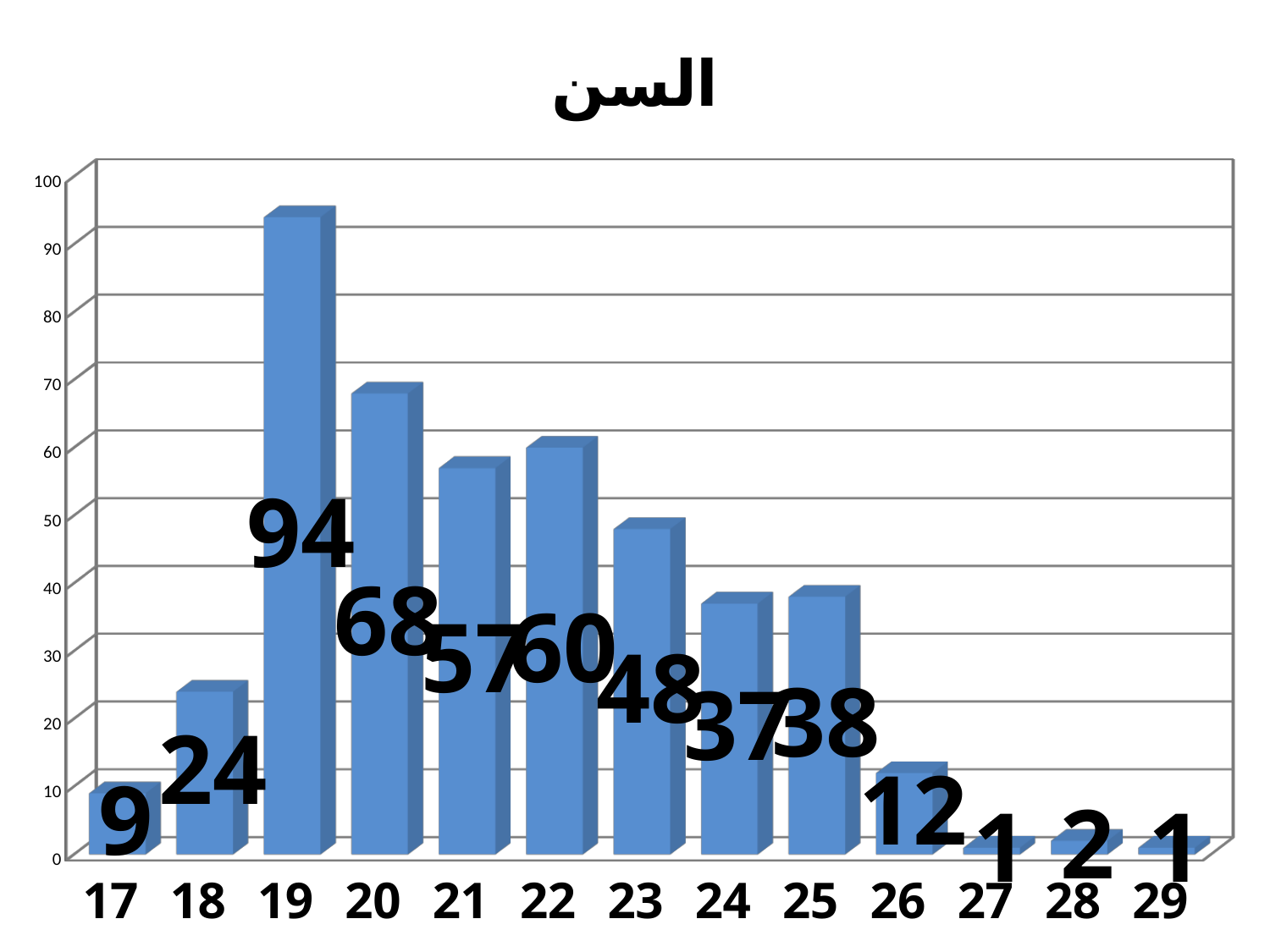
What is the value for age 19? 94 Which is larger, the value for age 21 or the value for age 22? 22 Is the value for age 19 greater or less than 90? greater What is the value for age 23? 48 What is the value for age 26? 12 What is the difference between the values for age 18 and age 17? 15 Which is larger, the value for age 20 or the value for age 23? 20 What is the difference between the values for age 19 and age 20? 26 What kind of chart is shown on the slide? bar chart What is the title of the chart? السن Which age category has the highest value? 19 How many age categories are shown on the x axis? 13